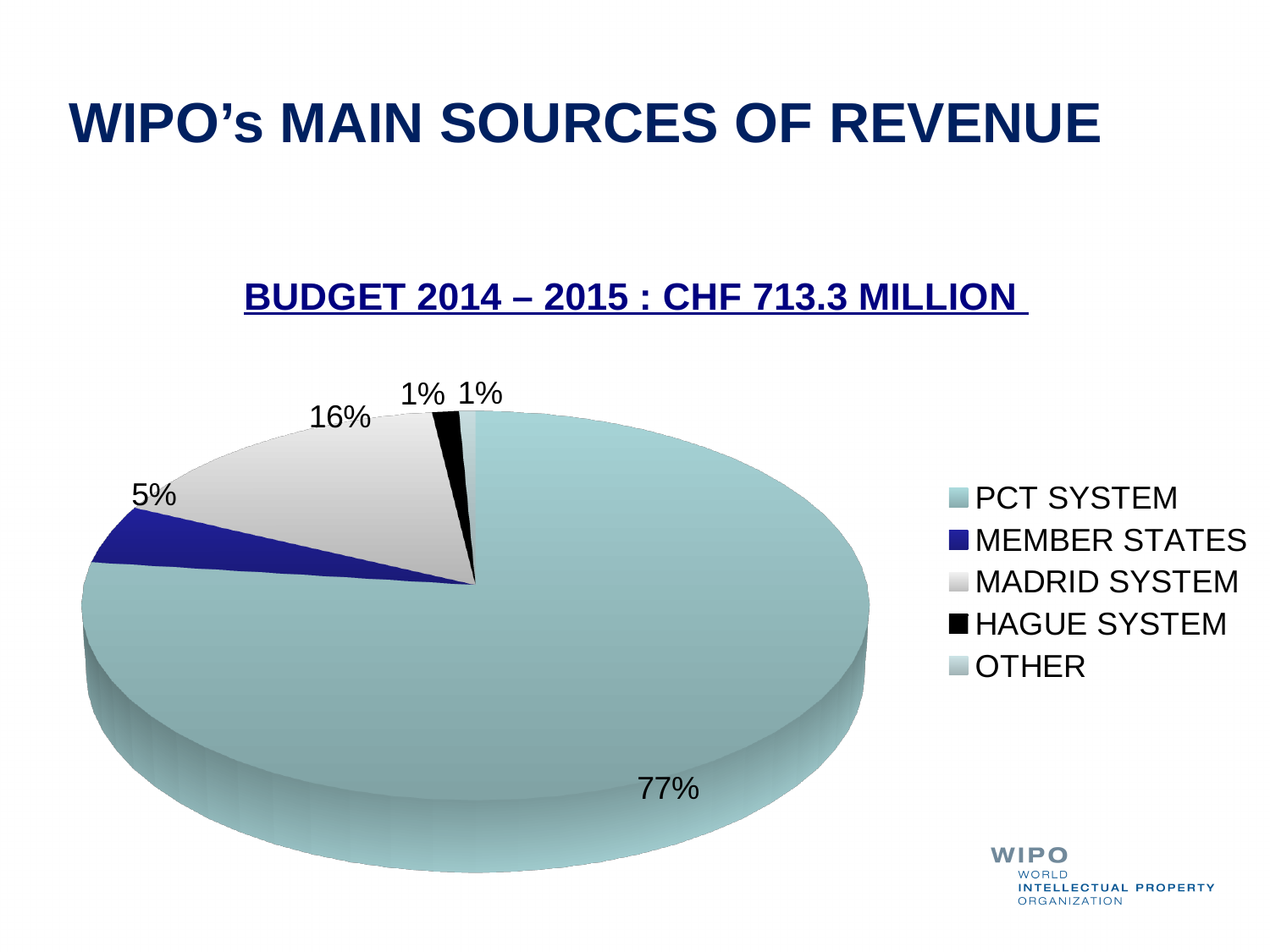
How many slices does the pie chart have? 5 How many entries does the legend list? 5 What share of revenue comes from MEMBER STATES? 5% Which source of revenue has the largest share? PCT SYSTEM What is the difference in percentage points between the MADRID SYSTEM share and the MEMBER STATES share? 11 Which is larger, the share for the MADRID SYSTEM or for MEMBER STATES? MADRID SYSTEM What is the difference in percentage points between the PCT SYSTEM share and the MADRID SYSTEM share? 61 What share of revenue comes from the PCT SYSTEM? 77% What share of revenue comes from the HAGUE SYSTEM? 1% What total budget for 2014 – 2015 is stated above the chart? CHF 713.3 MILLION What kind of chart is shown on the slide? pie chart What share of revenue comes from the MADRID SYSTEM? 16%